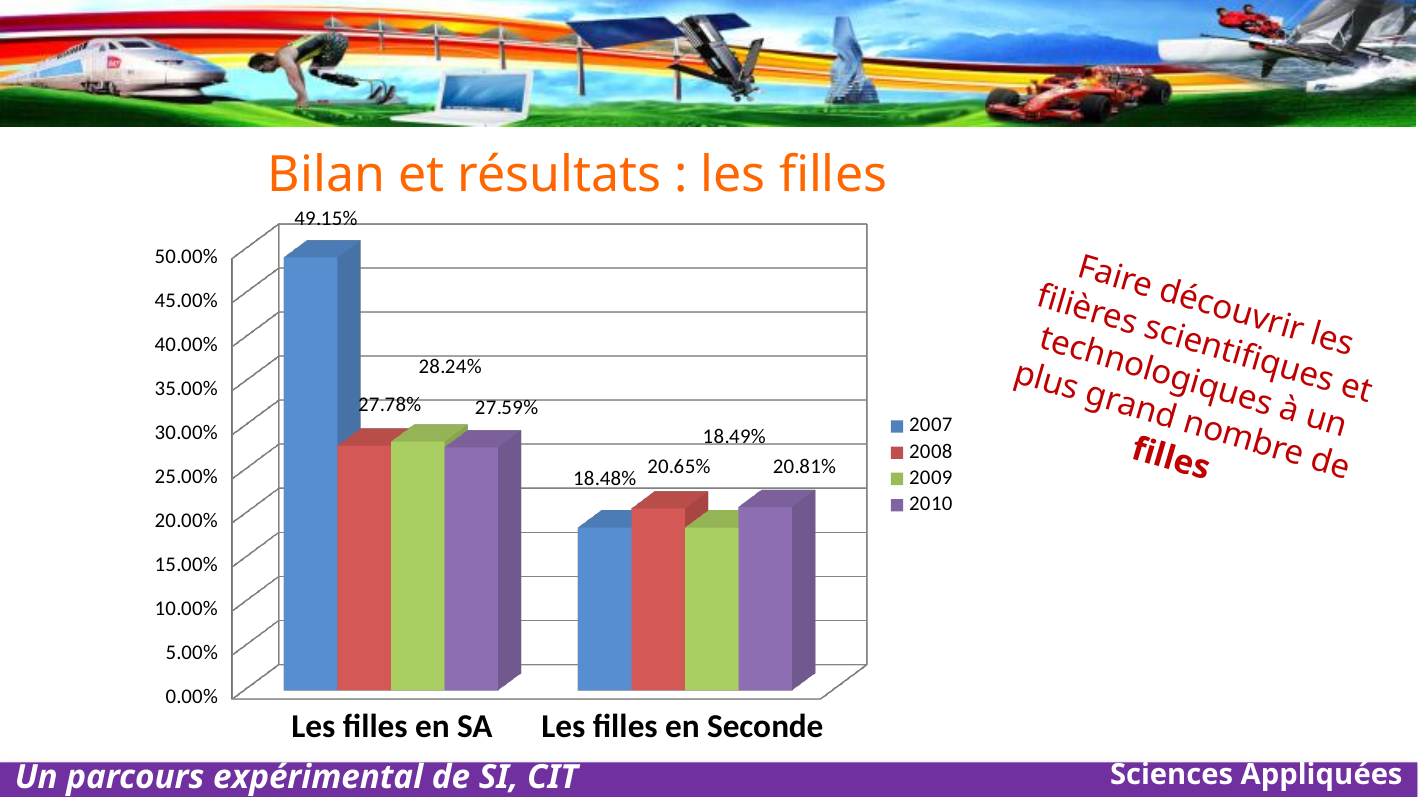
What is the title of the slide above the chart? Bilan et résultats : les filles What is the value for 2009 in the 'Les filles en SA' category? 28.24% What is the value for 2008 in the 'Les filles en Seconde' category? 20.65% Which is larger: the 2008 value for 'Les filles en SA' or the 2008 value for 'Les filles en Seconde'? Les filles en SA How many series does the legend list? 4 What is the difference between the 2007 values for 'Les filles en SA' and 'Les filles en Seconde'? 30.67% Which series has the highest value in the 'Les filles en SA' category? 2007 What is the value for 2007 in the 'Les filles en SA' category? 49.15% Which series has the lowest value in the 'Les filles en SA' category? 2010 What is the value for 2010 in the 'Les filles en Seconde' category? 20.81% What kind of chart is shown on the slide? Bar chart How many categories are shown on the x axis? 2